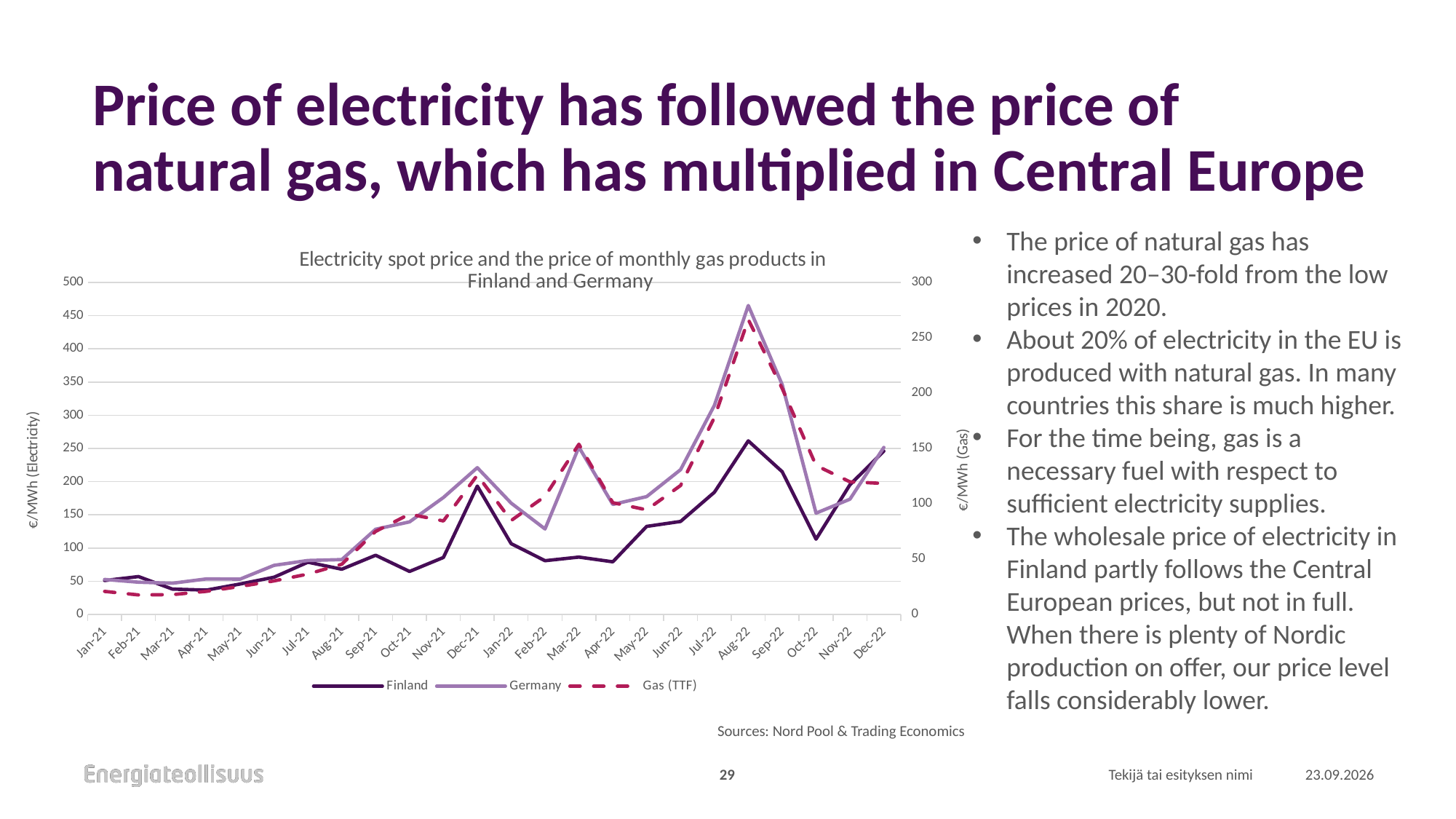
Which series in the legend is drawn as a dashed line? Gas (TTF) Does the Germany series rise or fall between Aug-22 and Oct-22? Fall Is the value for Finland in Aug-22 greater or less than 200 on the left axis? greater Is the value for Germany in Aug-22 greater or less than 400 on the left axis? greater Is the value for Germany in Feb-22 greater or less than 150 on the left axis? less What kind of chart is shown on the slide? Line chart How many series does the chart legend list? 3 In which month does the Finland series reach its highest value? Aug-22 Which is larger in Aug-22, the Finland value or the Germany value? Germany How many months are plotted along the x axis of the chart? 24 What is the title of the chart? Electricity spot price and the price of monthly gas products in Finland and Germany In which month does the Germany series reach its highest value? Aug-22